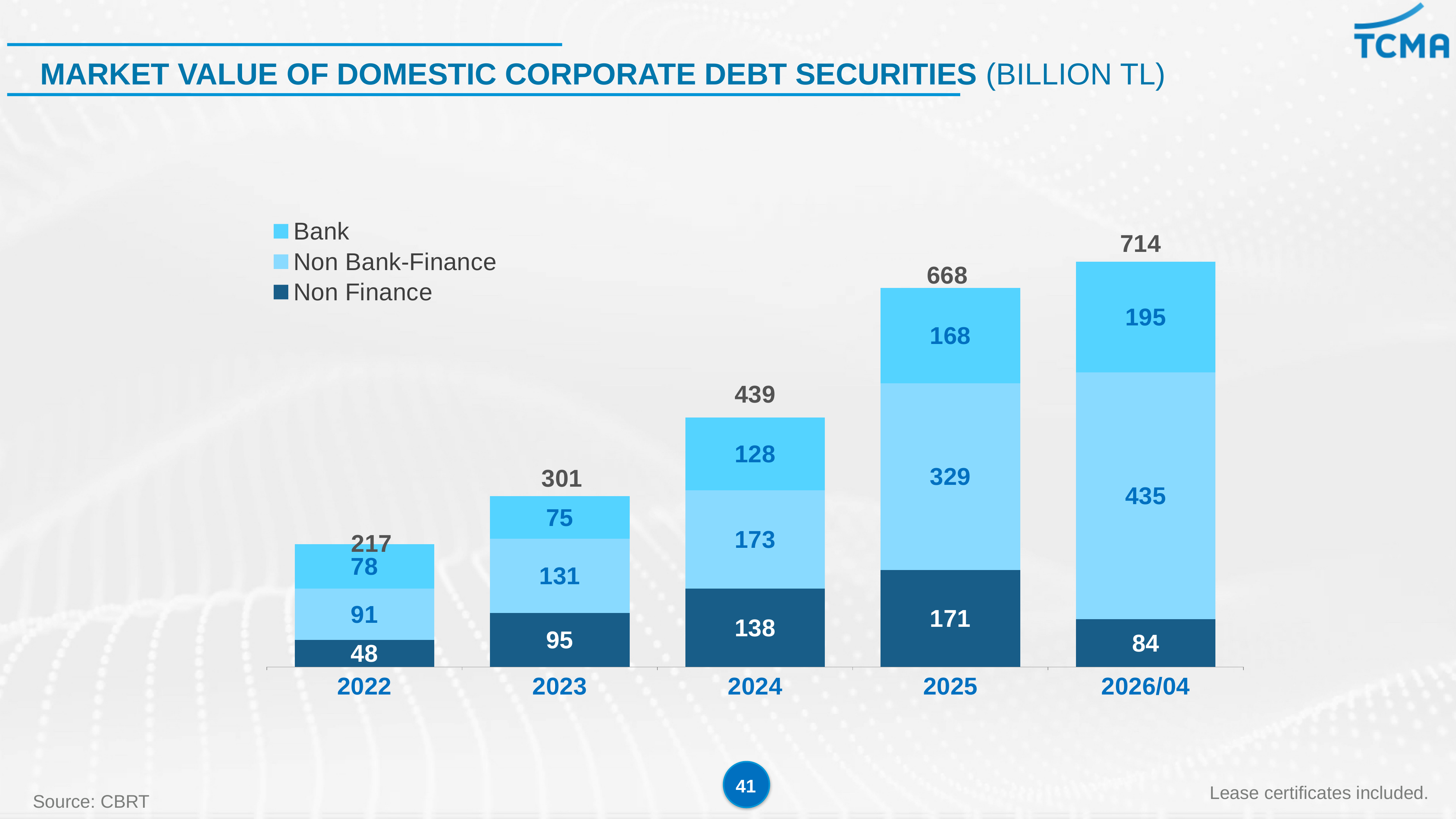
How many years are shown on the x axis? 5 Which year has the highest total market value? 2026/04 How many series does the legend list? 3 What kind of chart is shown on the slide? Stacked bar chart Do the total market values rise or fall from 2022 to 2026/04? Rise Which is larger, the Bank value for 2024 or the Non Finance value for 2025? Non Finance value for 2025 What is the difference between the Non Bank-Finance values for 2026/04 and 2025? 106 What is the total market value shown for 2025? 668 What is the Non Finance value for 2024? 138 What is the Non Bank-Finance value for 2023? 131 Which year has the lowest Non Finance value? 2022 What is the Bank value for 2026/04? 195